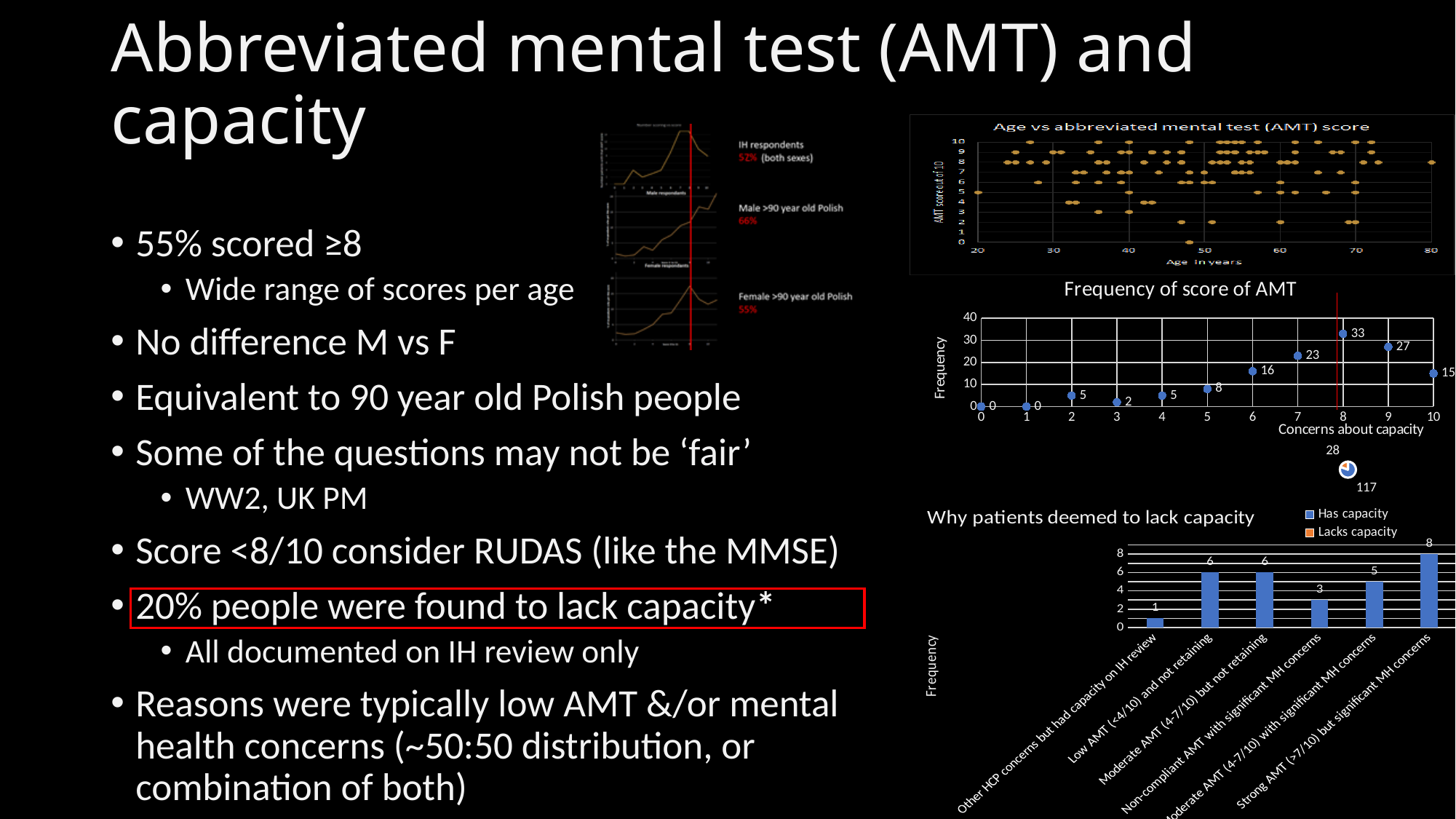
What kind of chart is 'Age vs abbreviated mental test (AMT) score'? Scatter chart In the 'Frequency of score of AMT' chart, which has the higher frequency, score 6 or score 7? Score 7 What kind of chart is 'Why patients deemed to lack capacity'? Bar chart In the 'Concerns about capacity' chart, what is the value for 'Has capacity'? 117 In the 'Frequency of score of AMT' chart, which score has the highest frequency? 8 In the 'Concerns about capacity' chart, what is the total of the two slices? 145 In the 'Frequency of score of AMT' chart, what is the frequency for a score of 8? 33 In the 'Why patients deemed to lack capacity' chart, what is the value for 'Non-compliant AMT with significant MH concerns'? 3 In the 'Frequency of score of AMT' chart, what is the difference between the frequencies for scores 9 and 10? 12 In the 'Why patients deemed to lack capacity' chart, what is the value for 'Strong AMT (>7/10) but significant MH concerns'? 8 In the 'Frequency of score of AMT' chart, how many score categories are shown on the x axis? 11 In the 'Why patients deemed to lack capacity' chart, which category has the lowest value? Other HCP concerns but had capacity on IH review